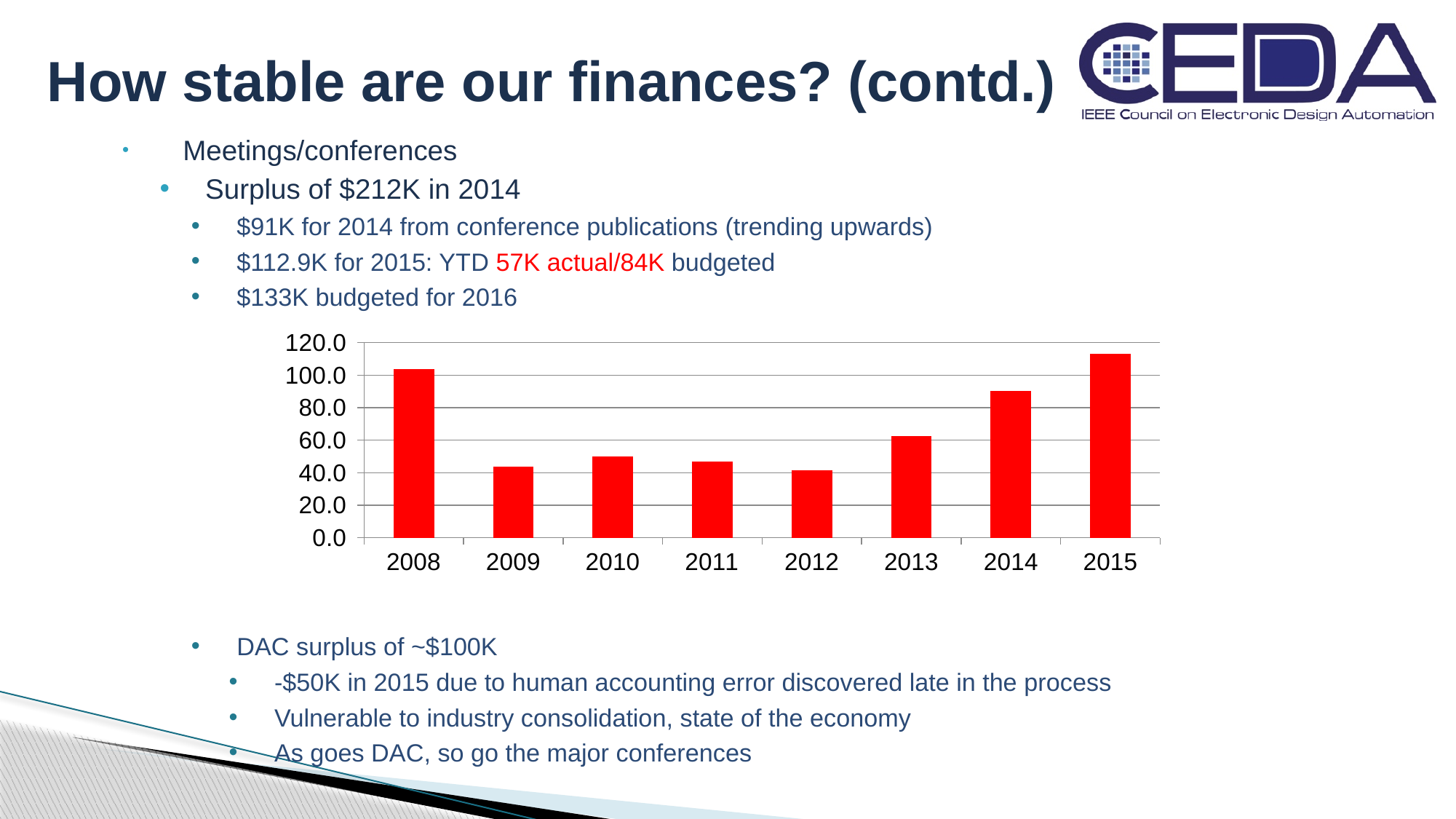
Is the value for 2014 greater or less than 80? greater Is the value for 2012 greater or less than 60? less Which year has the highest bar in the chart? 2015 Do the values rise or fall from 2012 to 2015? rise Which is larger, the value for 2014 or the value for 2013? 2014 Is the value for 2009 greater or less than 60? less Which is larger, the value for 2008 or the value for 2014? 2008 What kind of chart is shown on the slide? bar chart What colour are the bars in the chart? red How many years are shown on the x axis of the chart? 8